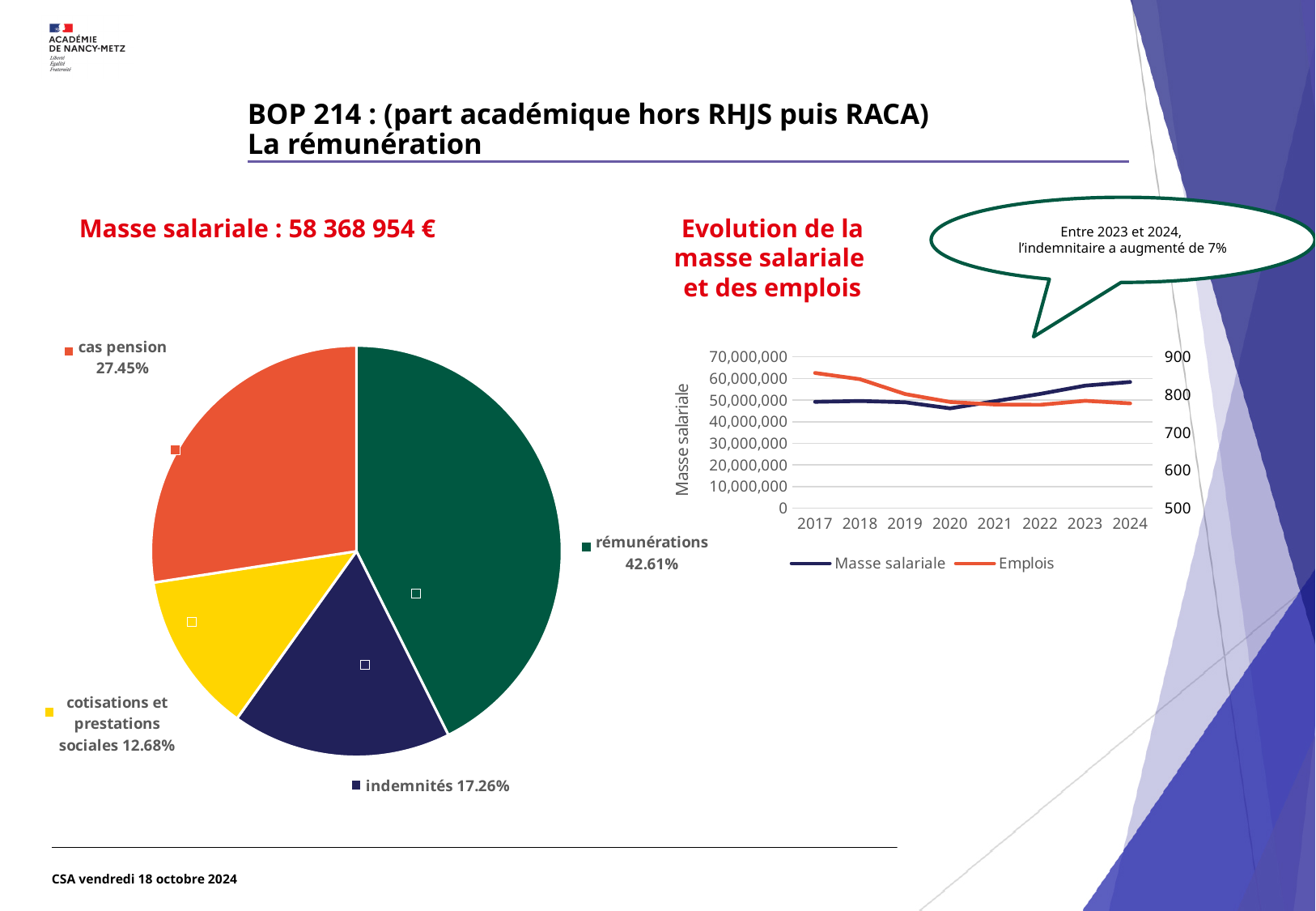
On the pie chart (Masse salariale), what share is rémunérations? 42.61% On the pie chart (Masse salariale), which category has the smallest share? cotisations et prestations sociales On the pie chart (Masse salariale), how many slices are there? 4 On the line chart (Evolution de la masse salariale et des emplois), is the Masse salariale value for 2024 greater or less than 50,000,000? greater On the line chart (Evolution de la masse salariale et des emplois), how many series does the legend list? 2 On the pie chart (Masse salariale), what is the difference in percentage points between rémunérations and indemnités? 25.35 On the pie chart (Masse salariale), what share is cas pension? 27.45% On the pie chart (Masse salariale), what share is cotisations et prestations sociales? 12.68% On the line chart (Evolution de la masse salariale et des emplois), is the Emplois value for 2017 greater or less than 800? greater On the line chart (Evolution de la masse salariale et des emplois), does the Emplois series rise or fall overall from 2017 to 2024? fall What kind of chart is the chart on the right of the slide (Evolution de la masse salariale et des emplois)? line chart On the pie chart (Masse salariale), which category has the largest share? rémunérations